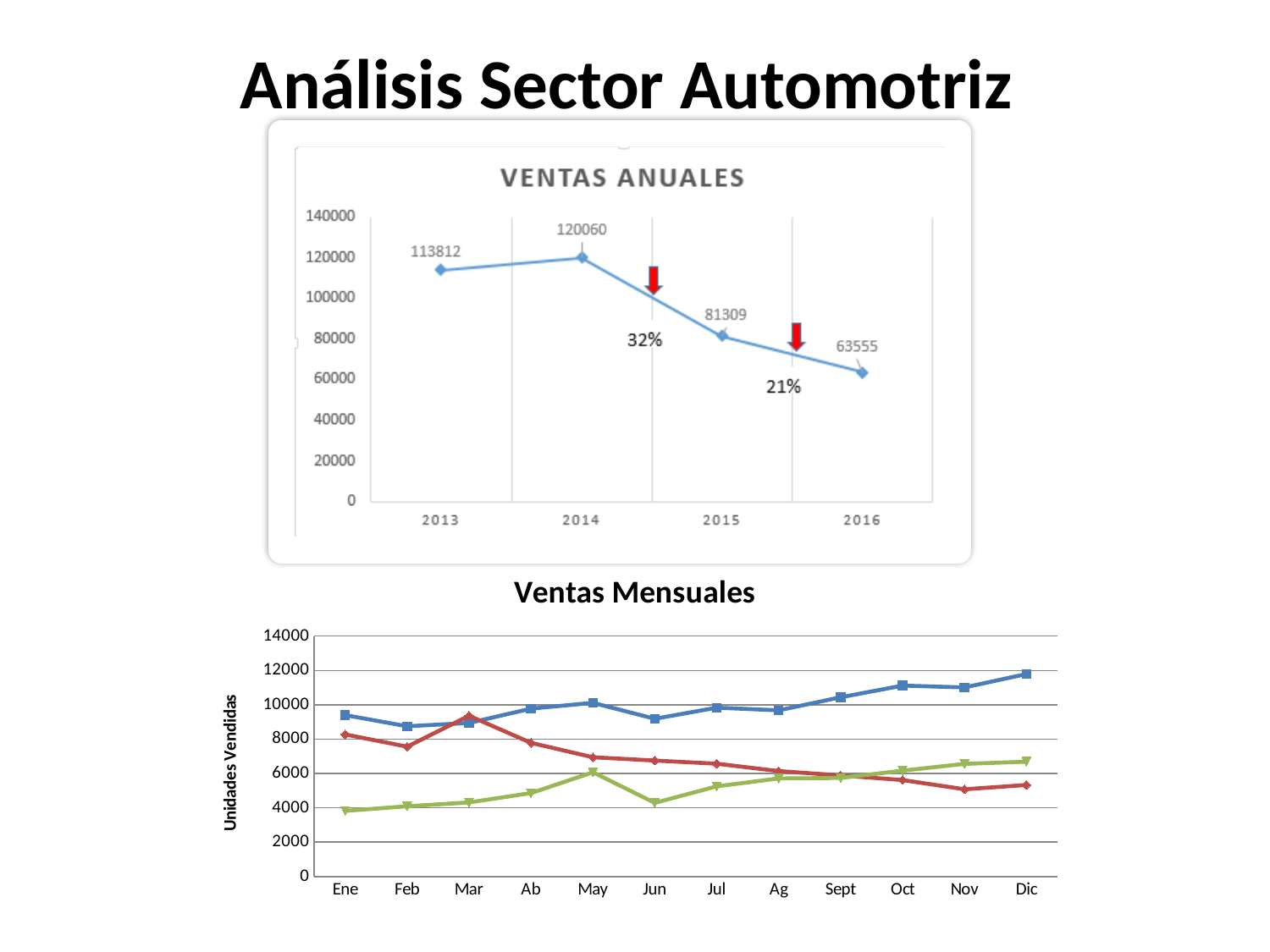
In the VENTAS ANUALES chart, what is the value for 2016? 63555 What kind of chart is the Ventas Mensuales chart? line chart In the VENTAS ANUALES chart, which year has the lowest value? 2016 In the VENTAS ANUALES chart, what is the value for 2014? 120060 In the VENTAS ANUALES chart, which is larger, the value for 2013 or the value for 2015? 2013 In the VENTAS ANUALES chart, what is the difference between the 2014 and 2015 values? 38751 In the Ventas Mensuales chart, is the value of the blue series for Dic greater or less than 10000? greater In the VENTAS ANUALES chart, how many years are plotted? 4 In the VENTAS ANUALES chart, which year has the highest value? 2014 In the VENTAS ANUALES chart, what percentage is annotated next to the drop between 2014 and 2015? 32% In the Ventas Mensuales chart, how many months are shown on the x axis? 12 In the Ventas Mensuales chart, does the red series rise or fall from Mar to Nov? fall